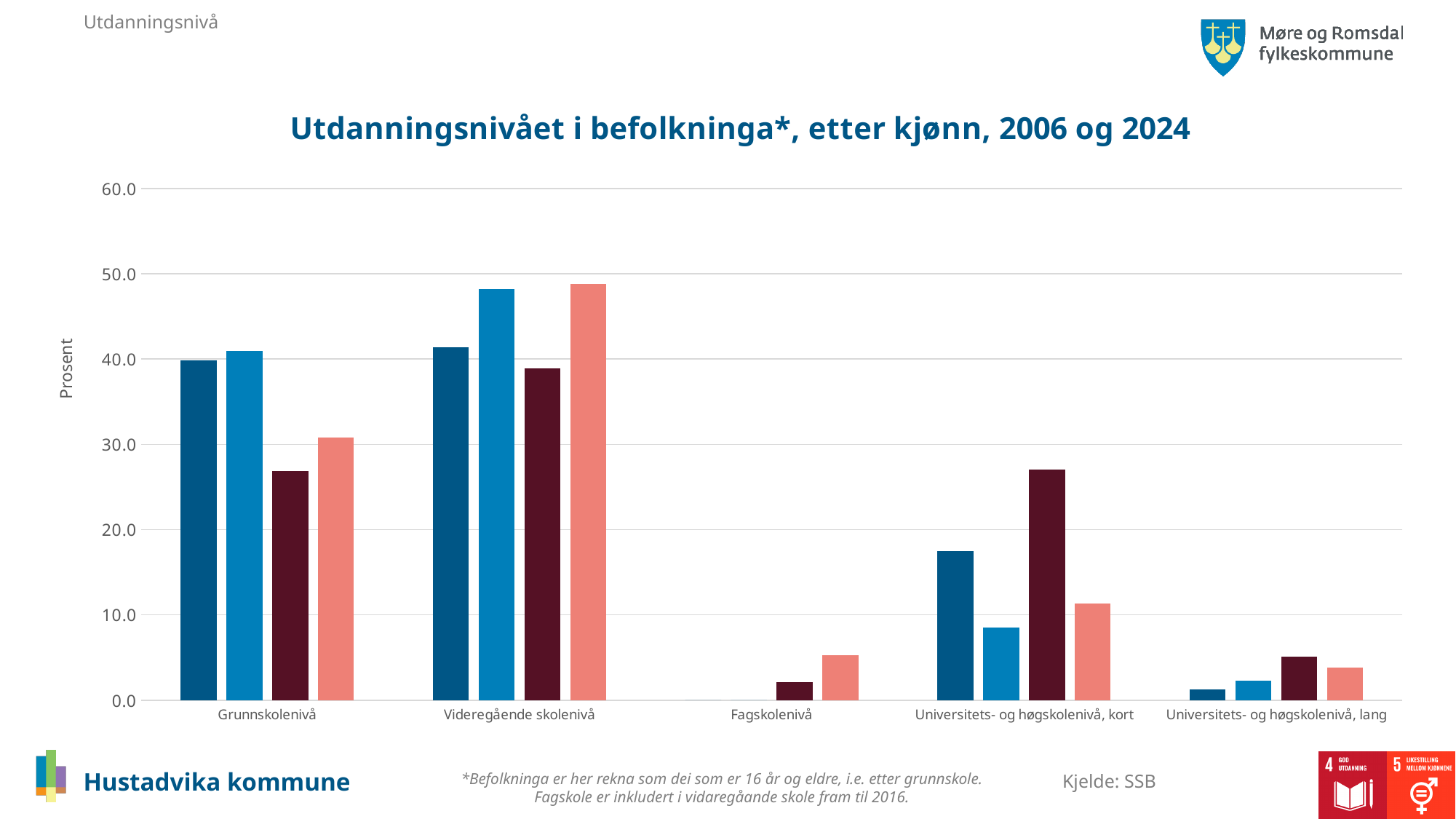
Is the value of the dark red (maroon) bar for Universitets- og høgskolenivå, kort greater or less than 20? greater For Grunnskolenivå, which is larger: the dark blue bar or the dark red (maroon) bar? the dark blue bar Is the value of the dark red (maroon) bar for Grunnskolenivå greater or less than 30? less What kind of chart is shown on the slide? bar chart Is the value of the light blue bar for Universitets- og høgskolenivå, kort greater or less than 10? less How many education-level categories are shown on the x axis? 5 What is the title of the chart? Utdanningsnivået i befolkninga*, etter kjønn, 2006 og 2024 What is the label on the vertical axis? Prosent For Universitets- og høgskolenivå, kort, which is larger: the light blue bar or the dark red (maroon) bar? the dark red (maroon) bar Which category has only two bars plotted? Fagskolenivå